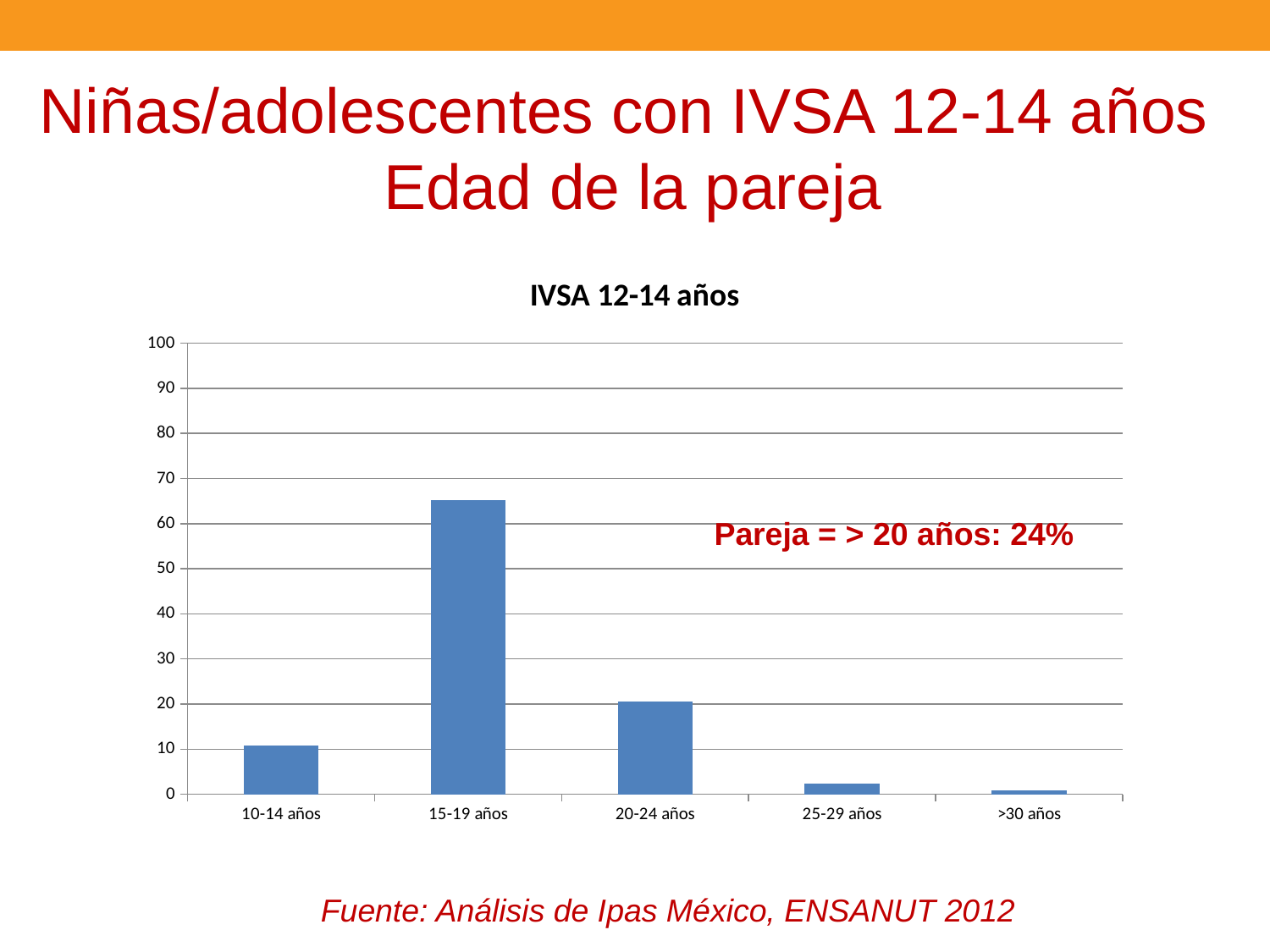
Is the value for 15-19 años greater or less than 70? less What is the title of the chart? IVSA 12-14 años Which is larger, the value for 10-14 años or the value for 20-24 años? 20-24 años How many age categories are shown on the x axis of the chart? 5 What percentage does the red annotation on the chart give for partners over 20 years old (Pareja = > 20 años)? 24% Is the value for 15-19 años greater or less than 60? greater Is the value for 25-29 años greater or less than 10? less Do the values rise or fall along the x axis from 15-19 años to >30 años? fall Which age category has the highest bar in the chart? 15-19 años What kind of chart is shown on the slide? bar chart